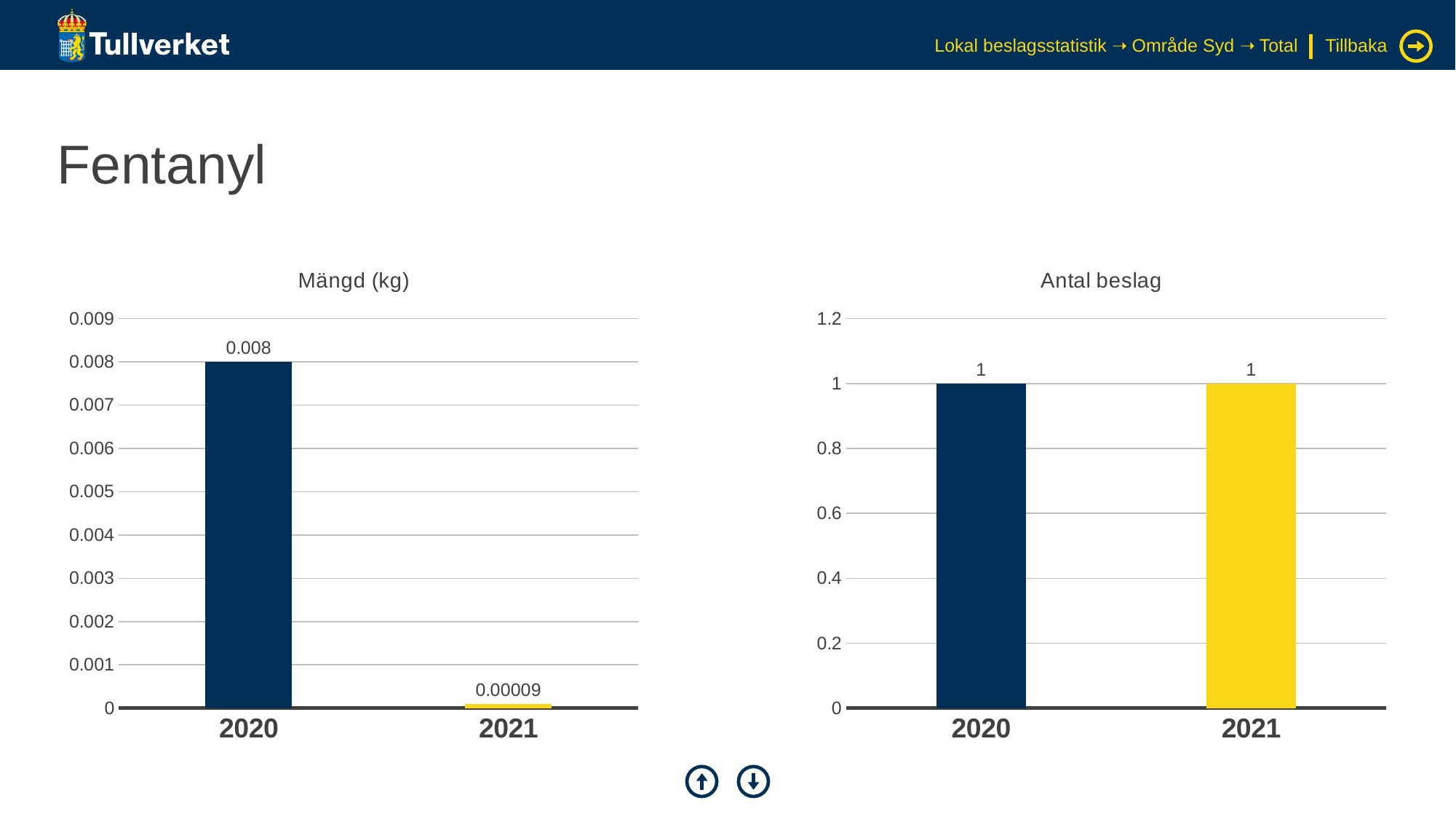
How many years are shown in the 'Antal beslag' chart? 2 In the 'Mängd (kg)' chart, what is the value for 2021? 0.00009 What is the title of the chart on the right side of the slide? Antal beslag In the 'Mängd (kg)' chart, is the value for 2020 greater or less than 0.005? greater In the 'Mängd (kg)' chart, which year has the highest value? 2020 In the 'Mängd (kg)' chart, do the values rise or fall from 2020 to 2021? fall In the 'Mängd (kg)' chart, what is the value for 2020? 0.008 In the 'Antal beslag' chart, what is the value for 2020? 1 In the 'Antal beslag' chart, what colour is the bar for 2021? yellow In the 'Antal beslag' chart, what is the value for 2021? 1 In the 'Mängd (kg)' chart, which year has the lowest value? 2021 What kind of chart is the 'Mängd (kg)' chart? bar chart